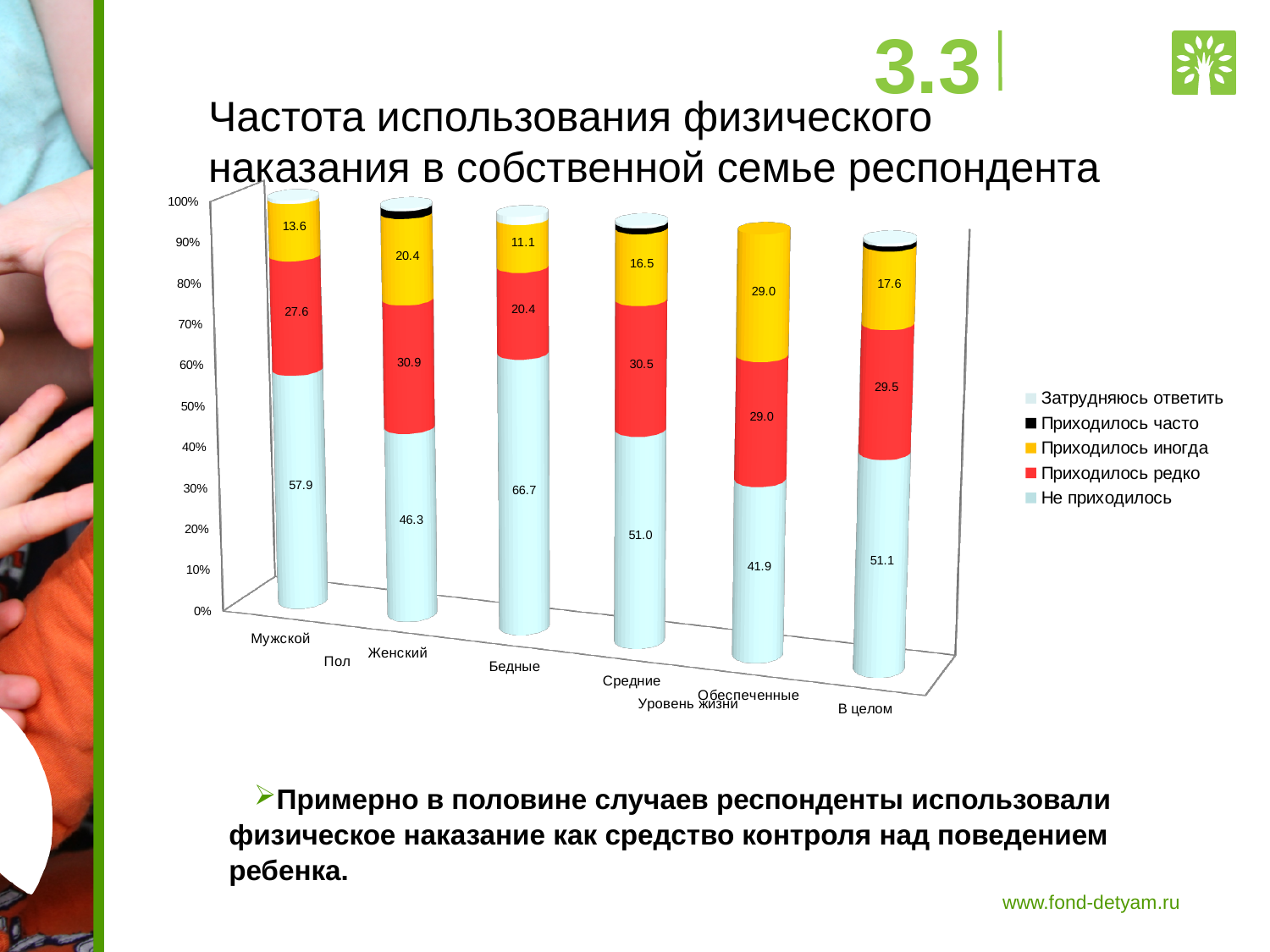
What is the difference between the "Не приходилось" values for "Мужской" and "Женский"? 11.6 Which is larger: the "Приходилось редко" value for "Женский" or for "Бедные"? Женский What type of chart is shown on the slide? Stacked bar chart Which category has the highest value for "Не приходилось"? Бедные What is the value of "Не приходилось" for the category "Мужской"? 57.9 How many series does the legend list? 5 What is the title of the chart on the slide? Частота использования физического наказания в собственной семье респондента What is the value of "Не приходилось" for the category "В целом"? 51.1 What is the value of "Приходилось редко" for the category "Женский"? 30.9 How many categories are shown on the x axis of the chart? 6 Which category has the lowest value for "Не приходилось"? Обеспеченные What is the value of "Приходилось иногда" for the category "Обеспеченные"? 29.0